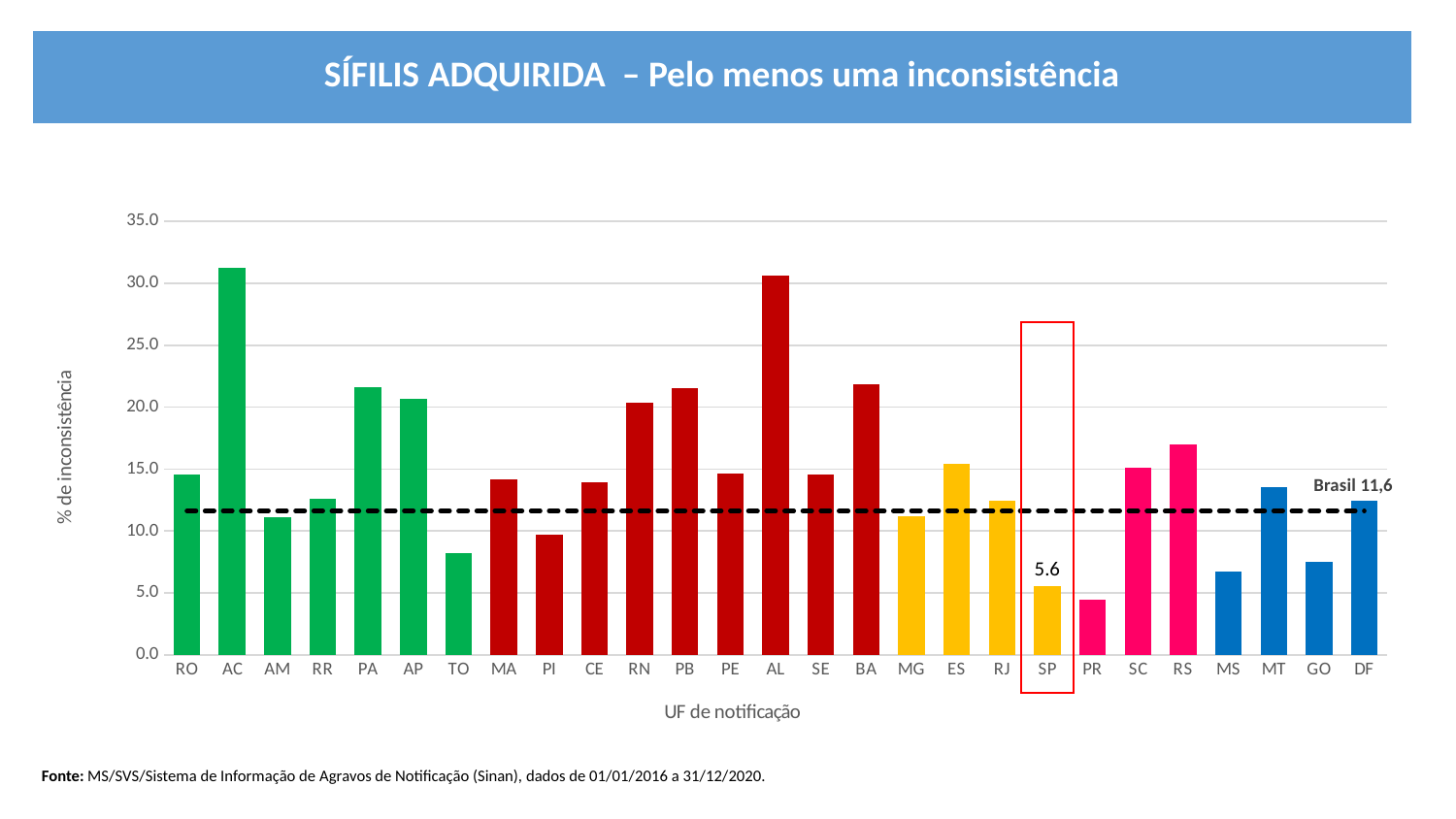
What is the title of the chart? SÍFILIS ADQUIRIDA – Pelo menos uma inconsistência Which is larger, the value for PA or the value for TO? PA What is the label of the x axis? UF de notificação Is the value for AC greater or less than 30.0? greater What kind of chart is shown on the slide? bar chart Is the value for TO greater or less than 10.0? less What value is given for Brasil by the dashed reference line? 11,6 What is the value shown for SP? 5.6 Is the value for BA greater or less than 20.0? greater Which is larger, the value for MT or the value for MS? MT Which UF has the lowest value? PR How many UFs (categories) are plotted on the x axis? 27